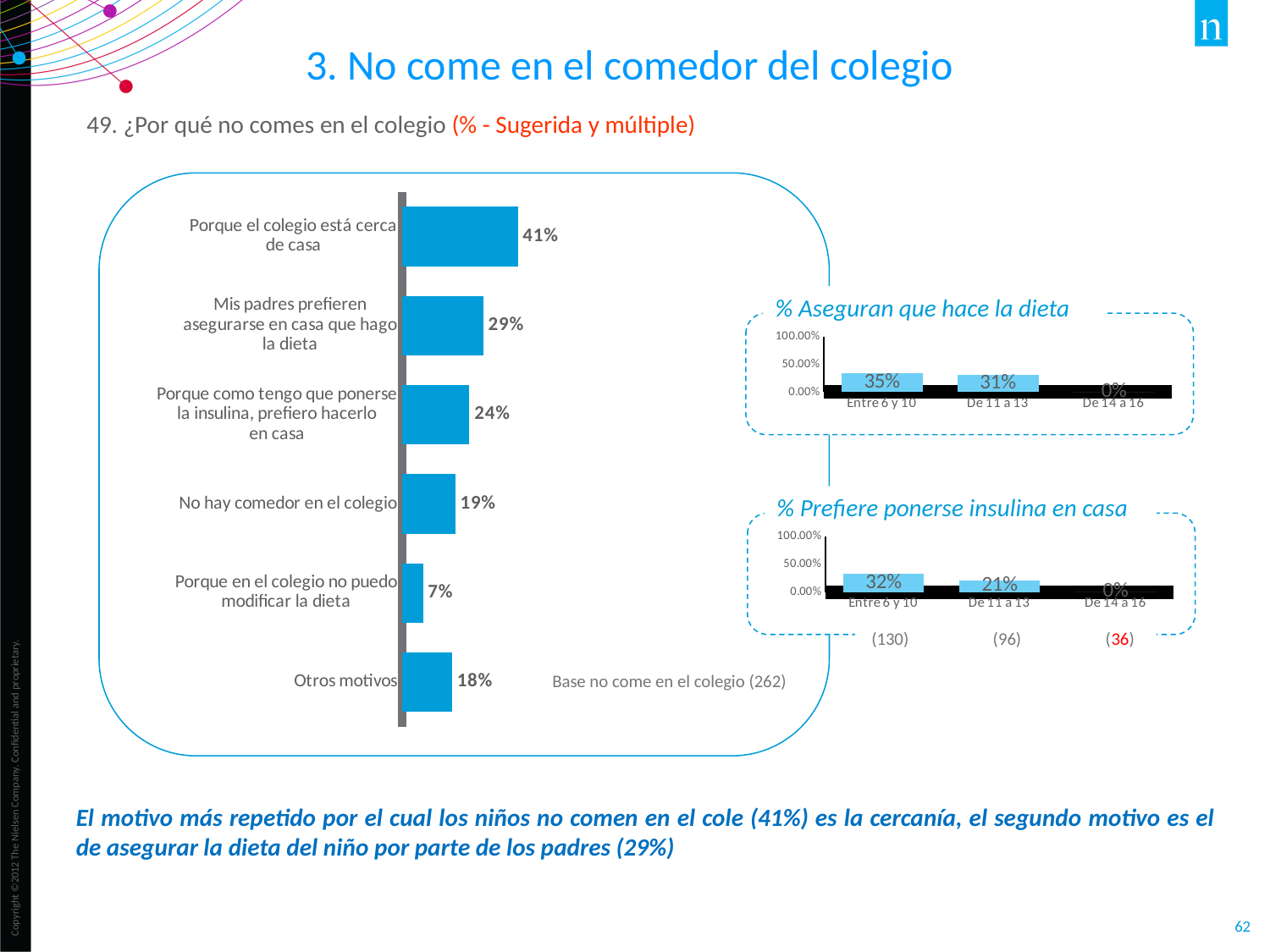
In the main bar chart on the left, which is larger: "Otros motivos" or "Porque en el colegio no puedo modificar la dieta"? Otros motivos How many categories does the main bar chart on the left show? 6 In the main bar chart on the left, what is the value for "No hay comedor en el colegio"? 19% In the main bar chart on the left, what is the difference between "Mis padres prefieren asegurarse en casa que hago la dieta" and "Porque como tengo que ponerse la insulina, prefiero hacerlo en casa"? 5% In the chart titled "% Aseguran que hace la dieta", what is the value for "De 14 a 16"? 0% In the main bar chart on the left, which category has the lowest value? Porque en el colegio no puedo modificar la dieta In the chart titled "% Prefiere ponerse insulina en casa", what is the value for "De 11 a 13"? 21% In the chart titled "% Aseguran que hace la dieta", what is the value for "Entre 6 y 10"? 35% In the main bar chart on the left, what is the value for "Porque el colegio está cerca de casa"? 41% In the chart titled "% Prefiere ponerse insulina en casa", do the values rise or fall from "Entre 6 y 10" to "De 14 a 16"? Fall What kind of chart is the main chart on the left? Bar chart In the main bar chart on the left, which category has the highest value? Porque el colegio está cerca de casa